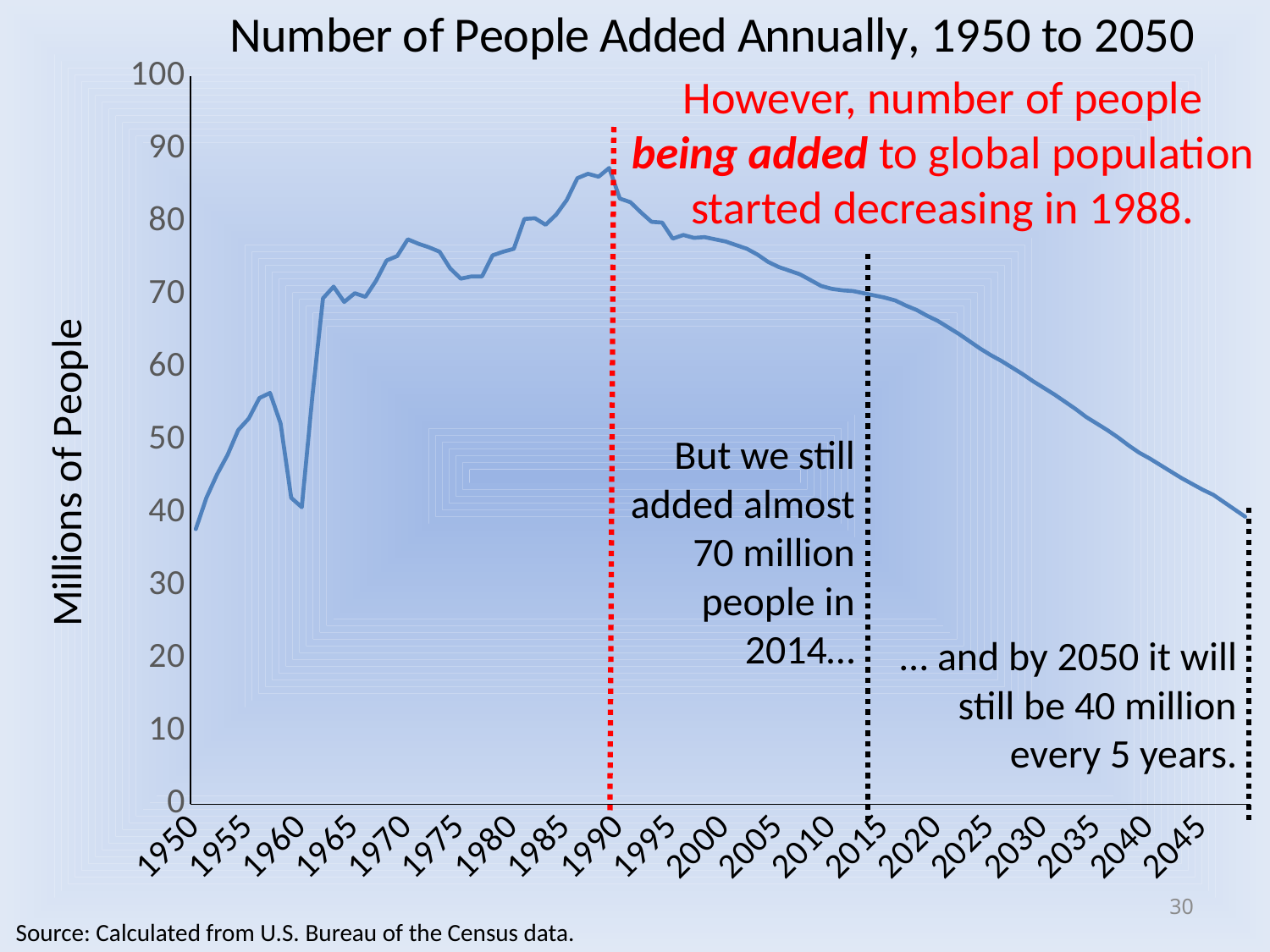
Is the value for 1950 greater or less than 40? less Is the value for 2045 greater or less than 40? greater Which is larger, the value for 1990 or the value for 2045? 1990 Is the value for 1960 greater or less than 50? less What type of chart is shown on the slide? line chart Do the values rise or fall along the x axis from 1990 to 2045? fall What is the title of the chart? Number of People Added Annually, 1950 to 2050 What is the label on the vertical axis of the chart? Millions of People